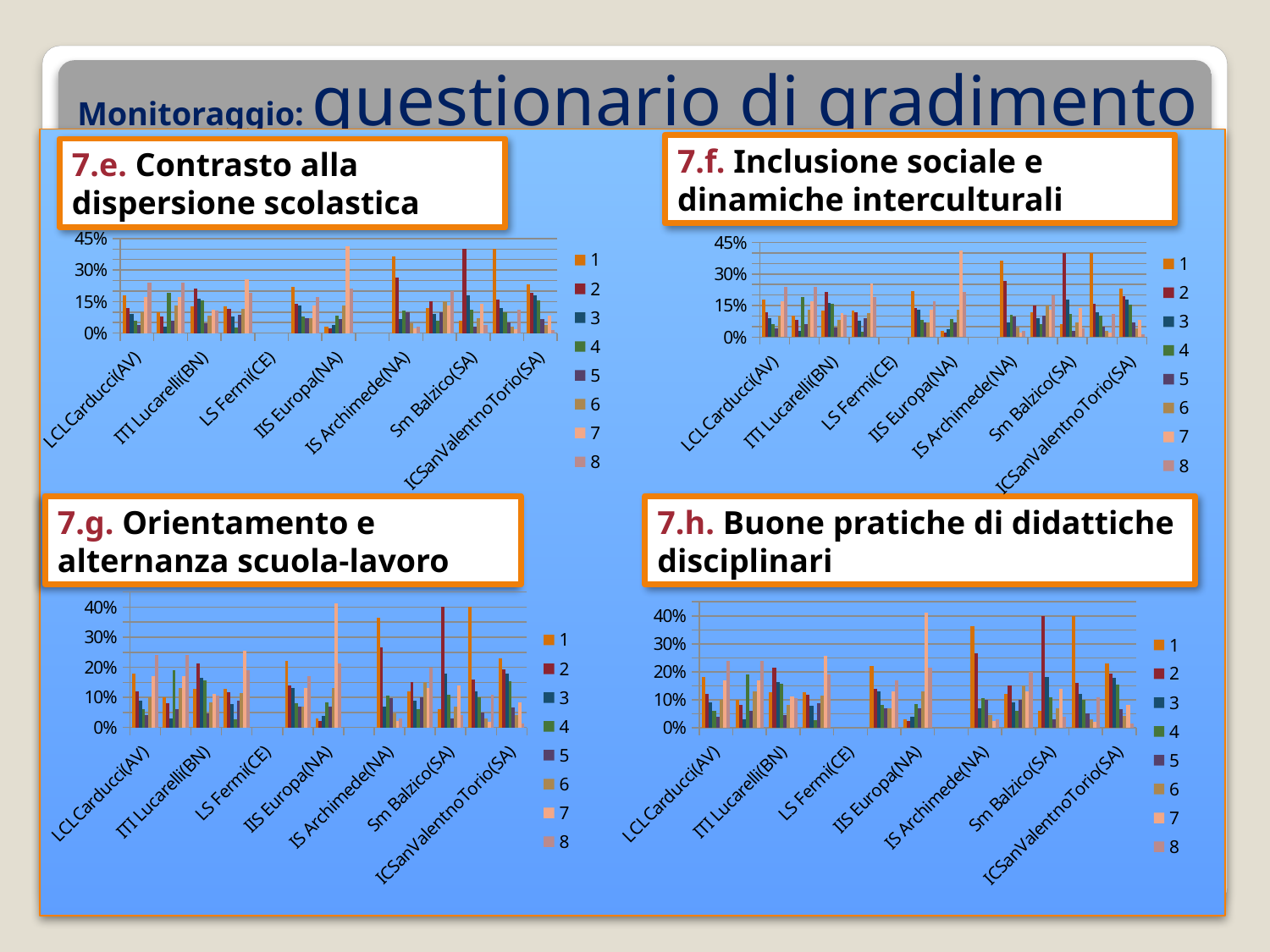
In the '7.e. Contrasto alla dispersione scolastica' chart, is the value of series 1 for IS Archimede(NA) greater or less than 30%? greater How many charts are shown on the slide? 4 In the '7.f. Inclusione sociale e dinamiche interculturali' chart, how many series does the legend list? 8 In the '7.g. Orientamento e alternanza scuola-lavoro' chart, is the value of series 7 for IIS Europa(NA) greater or less than 30%? greater In the '7.f. Inclusione sociale e dinamiche interculturali' chart, is the value of series 2 for Sm Balzico(SA) greater or less than 30%? greater What is the highest value shown on the y axis of the '7.h. Buone pratiche di didattiche disciplinari' chart? 40% What kind of chart is the '7.e. Contrasto alla dispersione scolastica' chart? bar chart What is the title of the chart in the bottom-right of the slide? 7.h. Buone pratiche di didattiche disciplinari